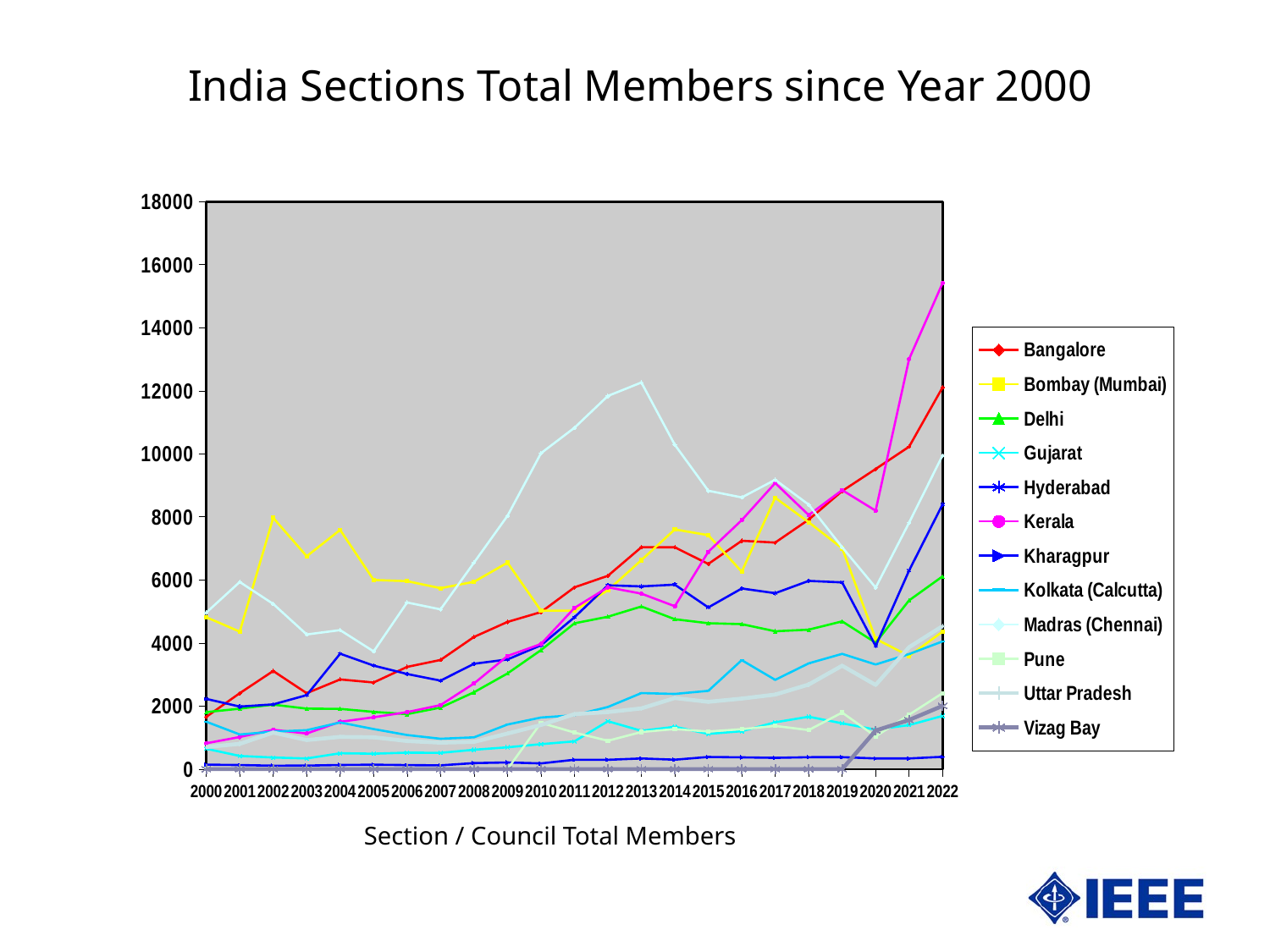
How many years are plotted along the x axis? 23 Which section has the lowest number of members in 2022? Kharagpur Does the Bangalore line generally rise or fall from 2000 to 2022? rise Which section has the highest number of members in 2022? Kerala Is the value for Vizag Bay in 2019 greater or less than 2000? less Is the value for Kerala in 2022 greater or less than 14000? greater What is the title of the chart? India Sections Total Members since Year 2000 In 2002, which has more members, Bombay (Mumbai) or Bangalore? Bombay (Mumbai) Is the value for Bangalore in 2022 greater or less than 10000? greater What kind of chart is shown on the slide? line chart Which section has the highest number of members in 2013? Madras (Chennai) How many series does the legend list? 12